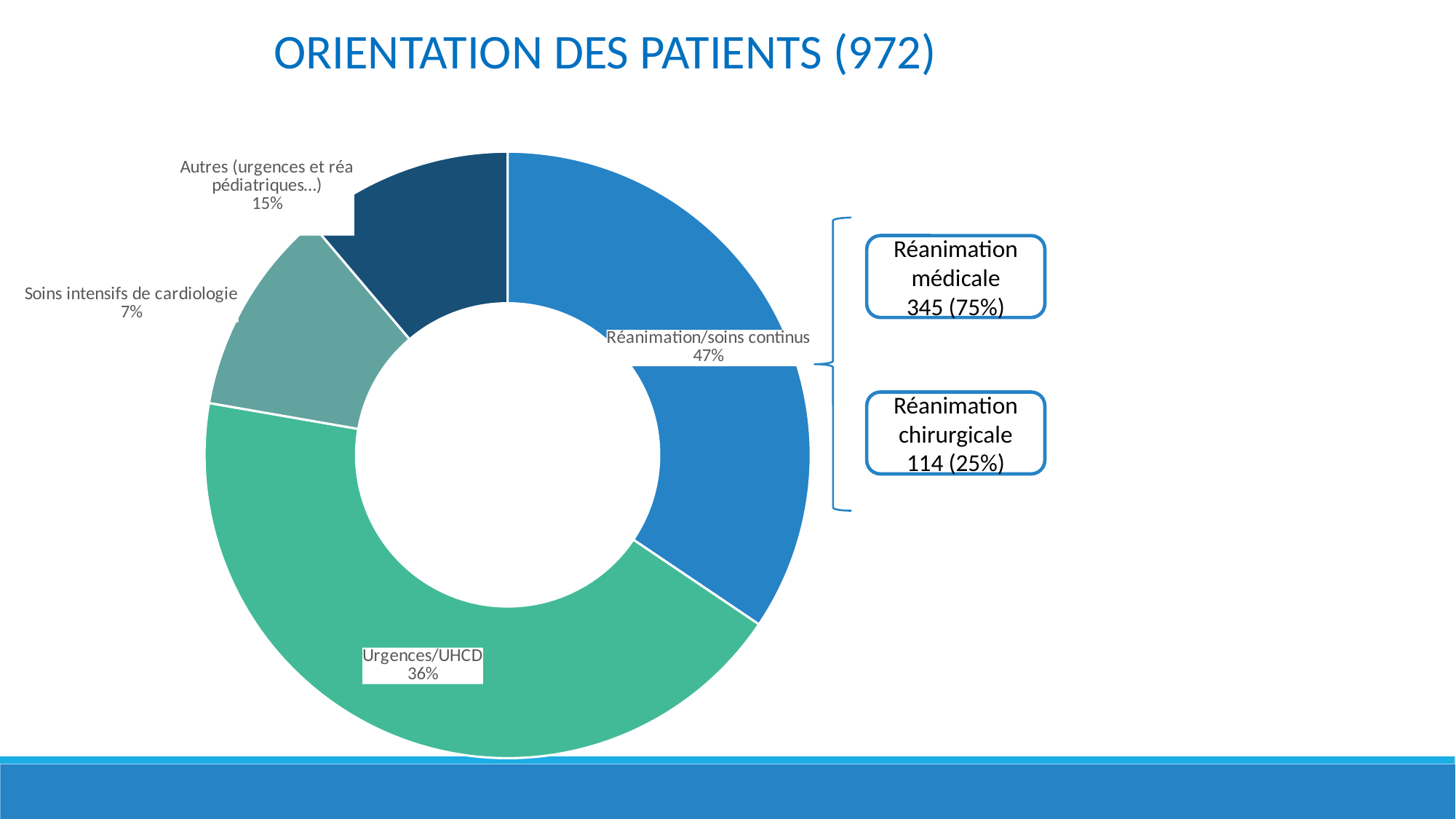
What share of patients fall under Autres (urgences et réa pédiatriques…)? 15% What is the difference in percentage points between Réanimation/soins continus and Urgences/UHCD? 11 Which is larger: the share for Autres (urgences et réa pédiatriques…) or the share for Soins intensifs de cardiologie? Autres (urgences et réa pédiatriques…) What share of patients were oriented to Urgences/UHCD? 36% What is the title of the slide? ORIENTATION DES PATIENTS (972) How many patients went to Réanimation médicale according to the callout box? 345 (75%) What share of patients were oriented to Soins intensifs de cardiologie? 7% What kind of chart is shown on the slide? Doughnut (pie) chart What share of patients were oriented to Réanimation/soins continus? 47% How many categories are shown in the chart? 4